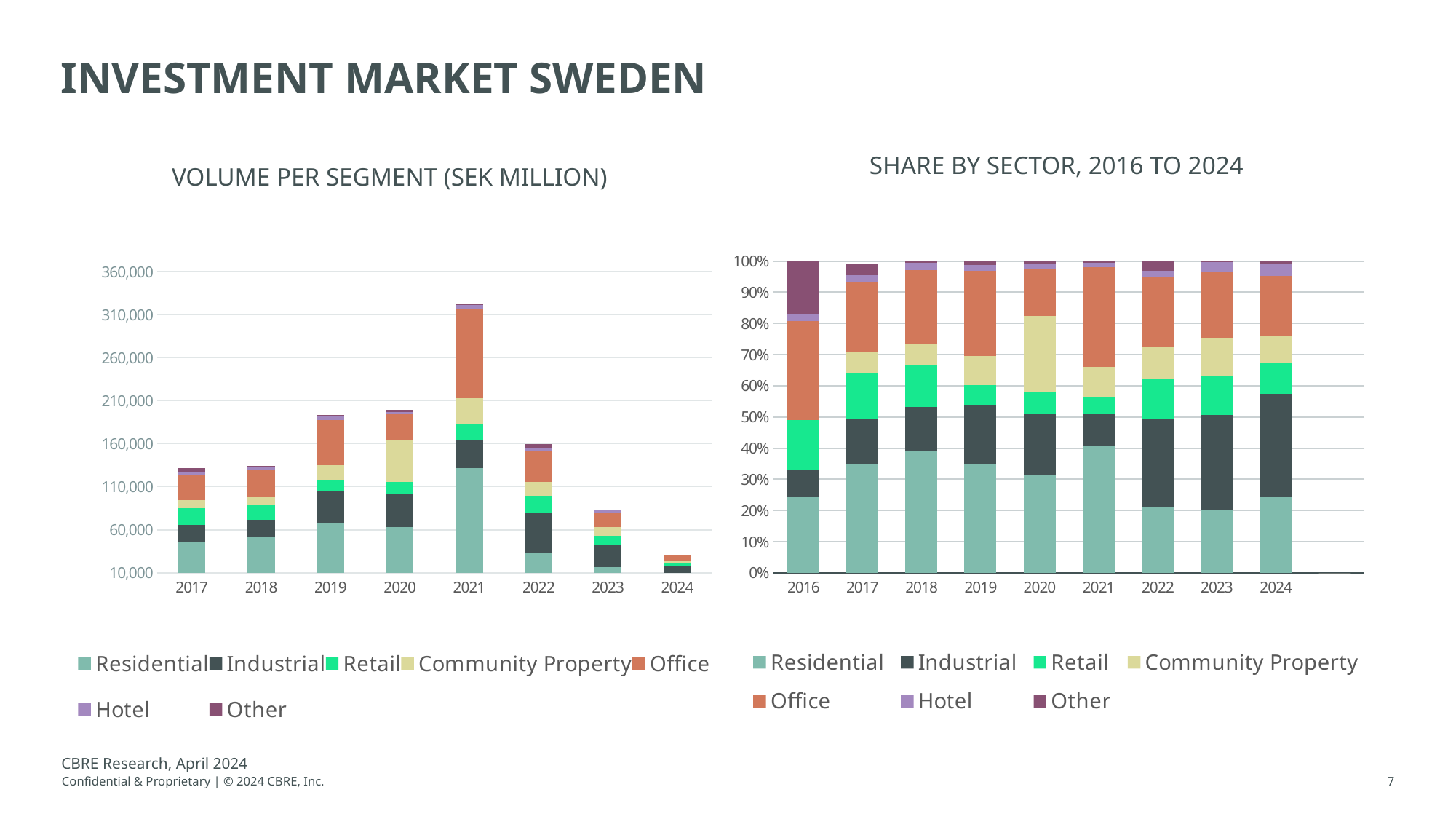
In the 'SHARE BY SECTOR, 2016 TO 2024' chart, which sector is shown in the darkest purple colour? Other In the 'VOLUME PER SEGMENT (SEK MILLION)' chart, is the total volume for 2021 greater or less than 260,000? greater In the 'VOLUME PER SEGMENT (SEK MILLION)' chart, which year has the lowest total volume? 2024 How many series does the legend of the 'SHARE BY SECTOR, 2016 TO 2024' chart list? 7 How many years are shown on the x axis of the 'VOLUME PER SEGMENT (SEK MILLION)' chart? 8 In the 'VOLUME PER SEGMENT (SEK MILLION)' chart, which year has the highest total volume? 2021 In the 'VOLUME PER SEGMENT (SEK MILLION)' chart, do total volumes rise or fall from 2021 to 2024? Fall In the 'VOLUME PER SEGMENT (SEK MILLION)' chart, is the total volume for 2023 greater or less than 110,000? less How many years are shown on the x axis of the 'SHARE BY SECTOR, 2016 TO 2024' chart? 9 In the 'SHARE BY SECTOR, 2016 TO 2024' chart, is the Residential share in 2016 greater or less than 30%? less What kind of chart is the 'VOLUME PER SEGMENT (SEK MILLION)' chart? Stacked bar chart In the 'VOLUME PER SEGMENT (SEK MILLION)' chart, which year has the larger total volume, 2019 or 2022? 2019